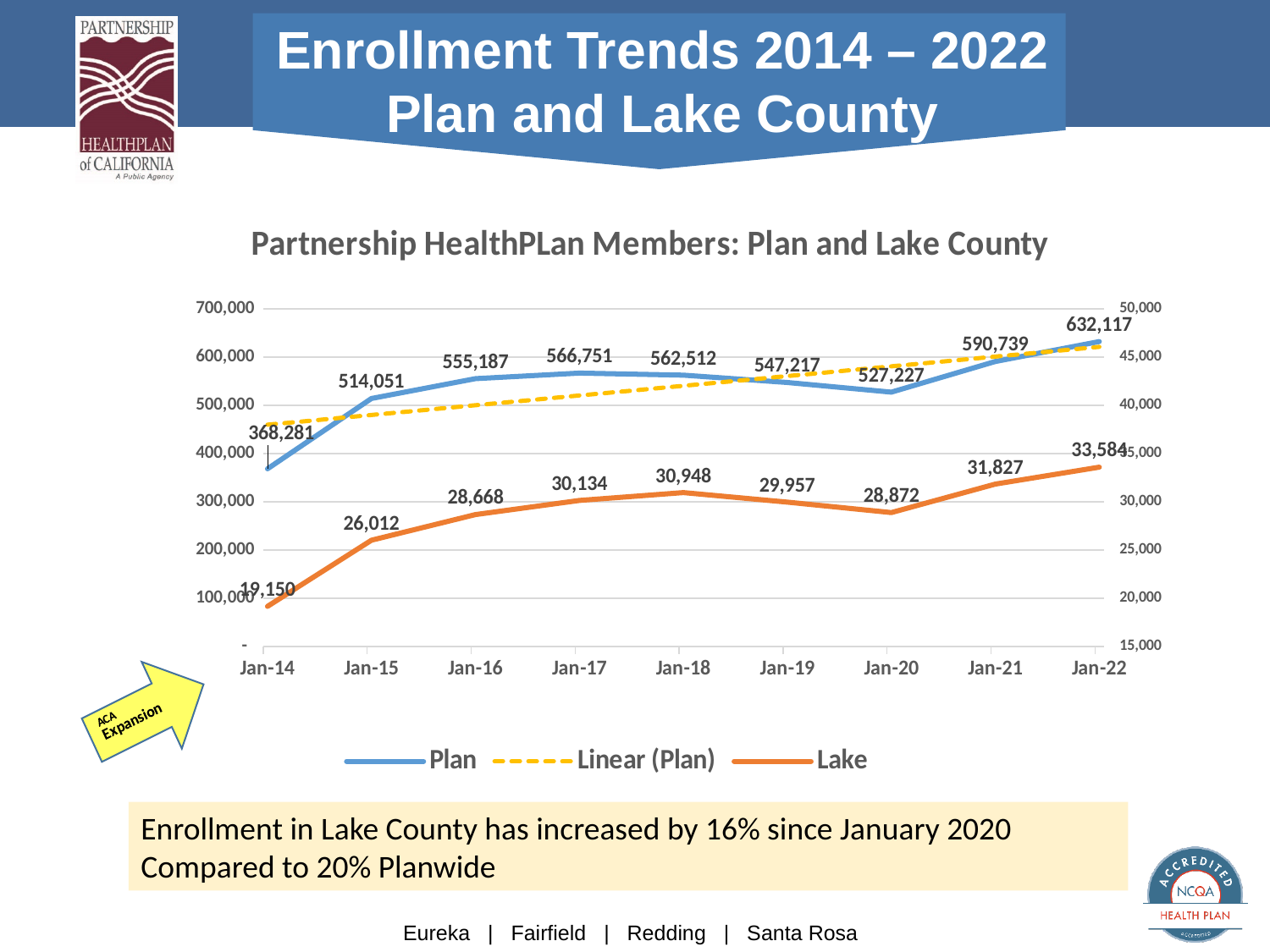
What is the Lake enrollment value shown for Jan-14? 19,150 What is the title of the chart? Partnership HealthPLan Members: Plan and Lake County What is the Plan enrollment value shown for Jan-22? 632,117 What is the difference between the Lake values for Jan-22 and Jan-14? 14,434 In which year does the Plan series reach its lowest value? Jan-14 What kind of chart is shown on the slide? Line chart What is the Lake value shown for Jan-18? 30,948 How many time points are plotted along the x axis? 9 How many entries does the legend list? 3 What is the difference between the Plan values for Jan-22 and Jan-21? 41,378 In which year does the Lake series reach its highest value? Jan-22 Which is larger, the Plan value for Jan-17 or the Plan value for Jan-20? Jan-17